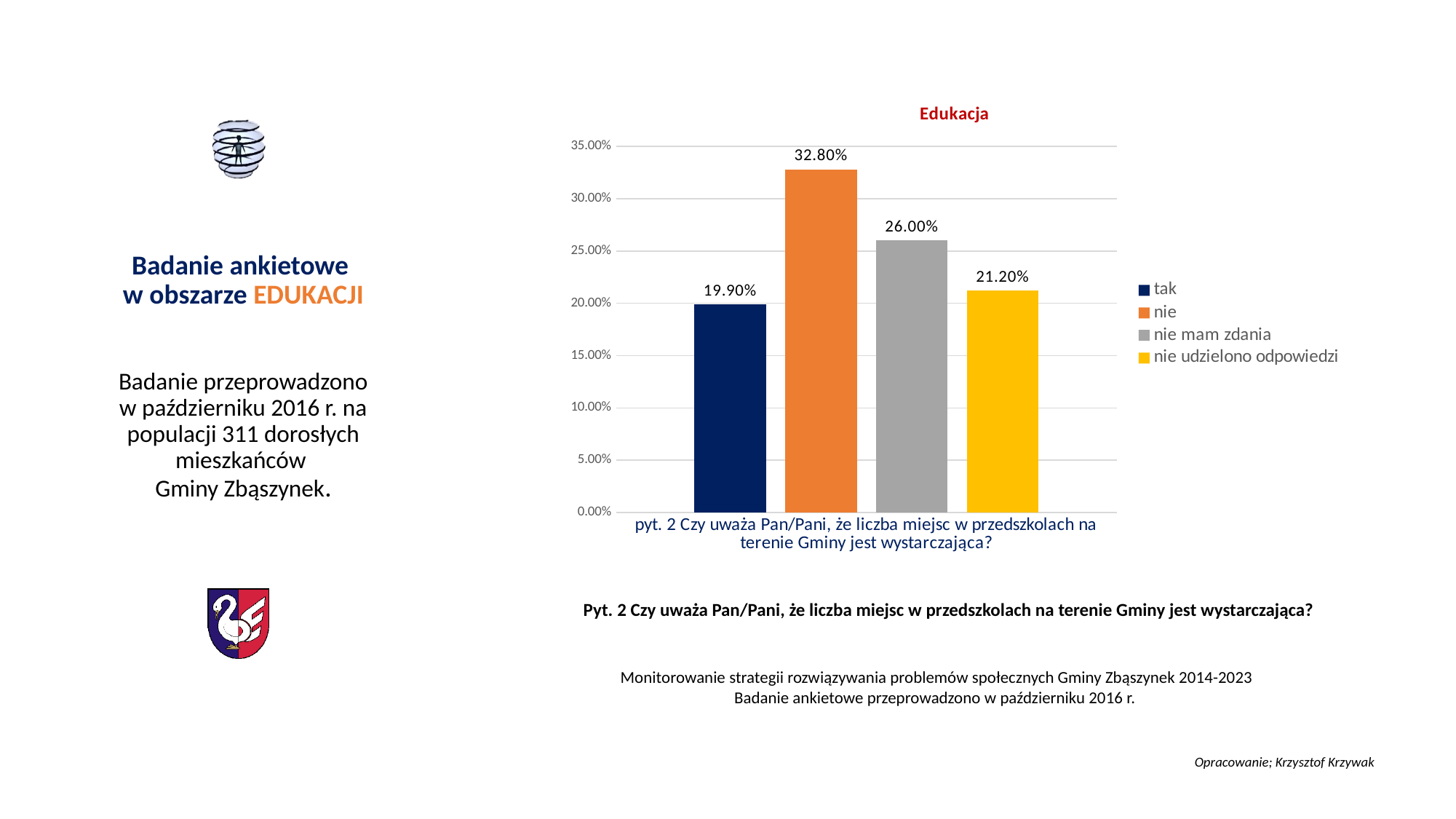
What kind of chart is shown on the slide? bar chart What is the value for "nie mam zdania" in the chart? 26.00% Which response has the highest value in the chart? nie What is the value for "nie" in the chart? 32.80% What is the title of the chart? Edukacja Which is larger, the value for "nie mam zdania" or the value for "nie udzielono odpowiedzi"? nie mam zdania What is the difference between the values for "nie" and "tak"? 12.90% Is the value for "nie" greater or less than 30.00%? greater What is the value for "nie udzielono odpowiedzi" in the chart? 21.20% How many series does the legend list? 4 Which response has the lowest value in the chart? tak What is the value for "tak" in the chart? 19.90%